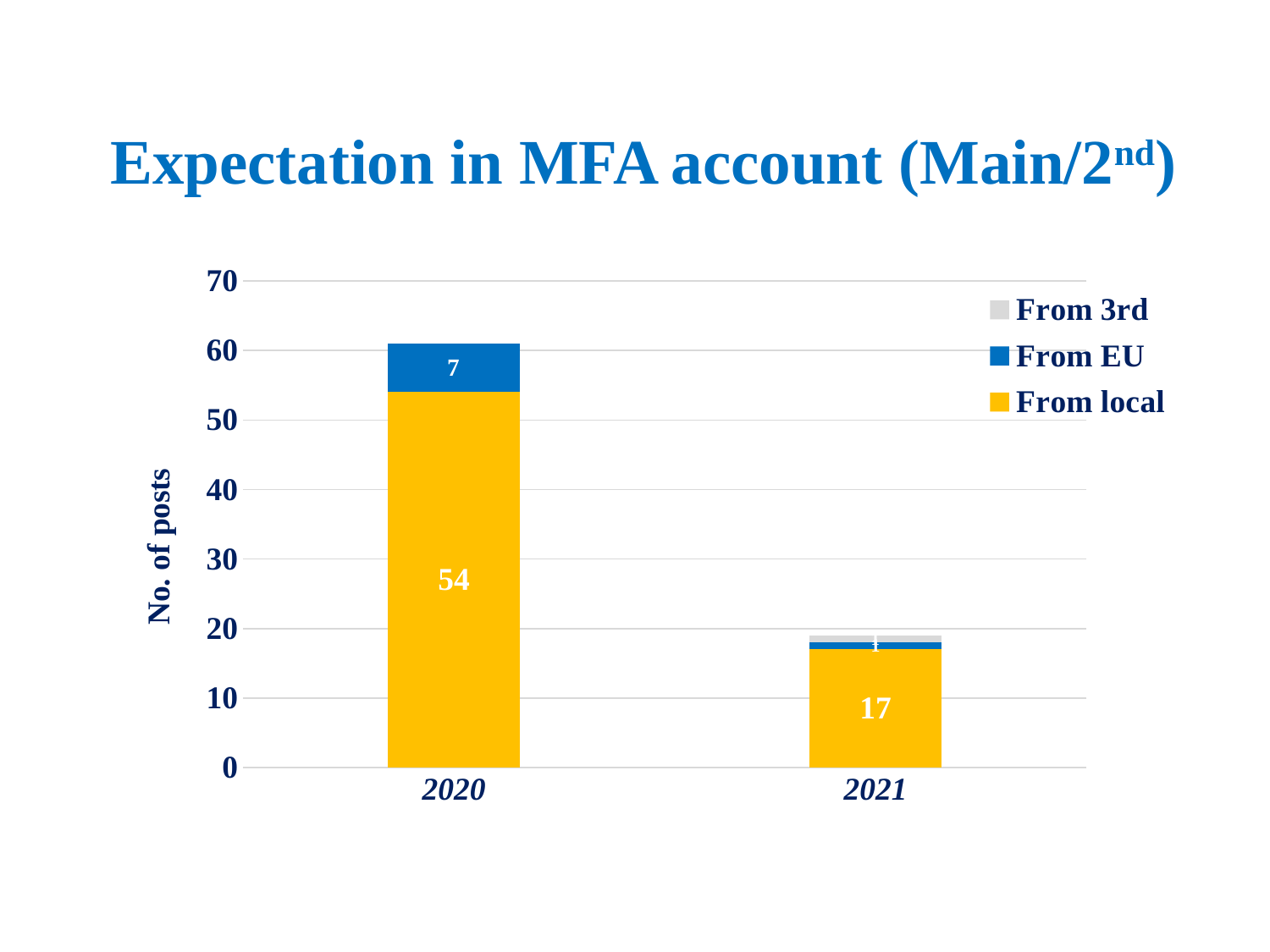
How many years are shown on the x axis? 2 Which year has the higher value for From local? 2020 Is the total height of the 2021 bar greater or less than 20? less What is the difference between the From local values for 2020 and 2021? 37 What is the value for From local in 2020? 54 What is the value for From EU in 2020? 7 What kind of chart is shown on the slide? Stacked bar chart What is the total of the stacked bar for 2020? 61 What is the label of the y axis? No. of posts What is the value for From local in 2021? 17 How many series does the legend list? 3 Do the total values rise or fall from 2020 to 2021? Fall